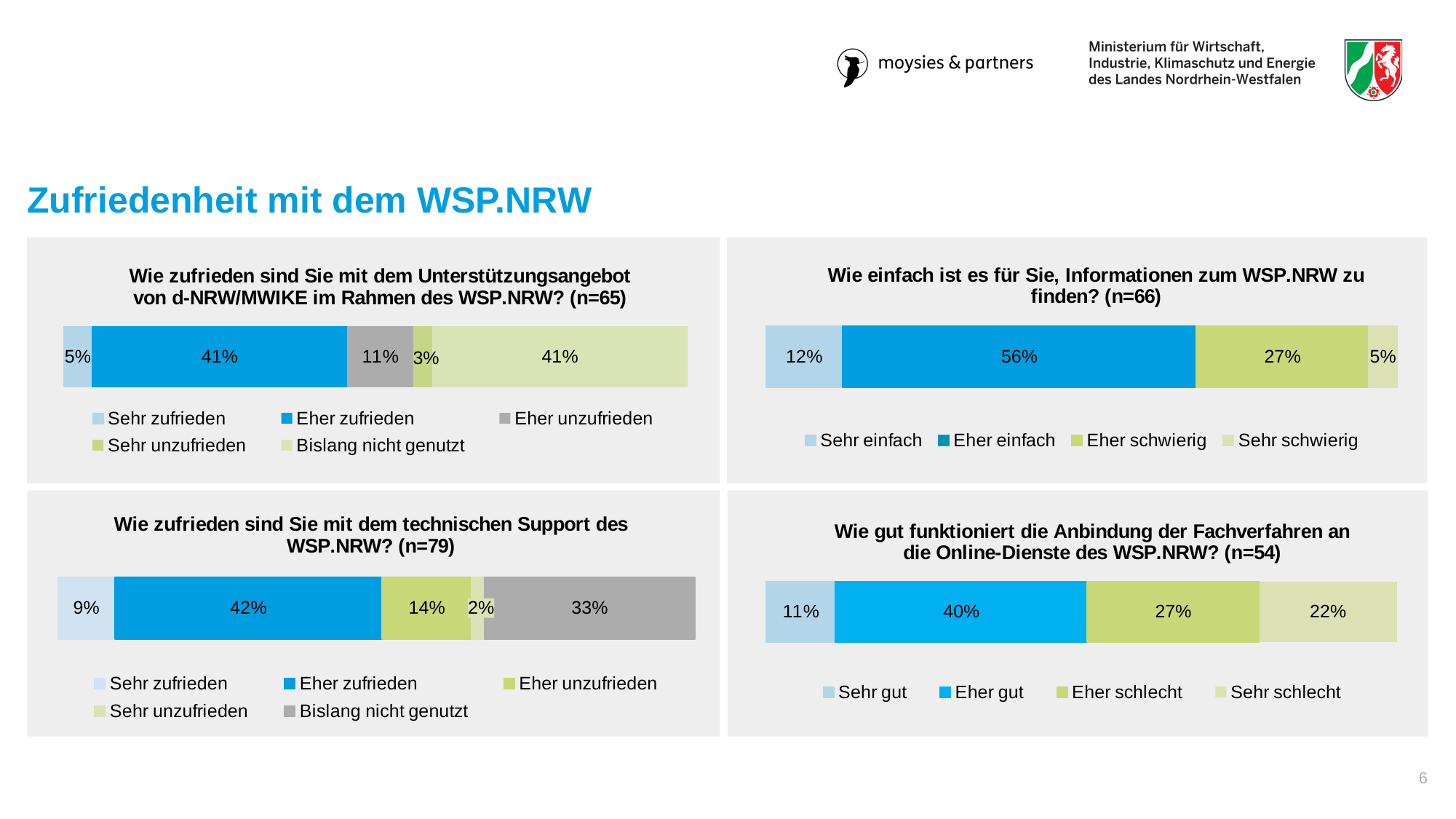
In the bottom-left chart (technischer Support), what share answered "Bislang nicht genutzt"? 33% In the top-right chart (Informationen zum WSP.NRW finden), what is the difference between the "Eher einfach" and "Eher schwierig" shares? 29 percentage points In the bottom-left chart (technischer Support), which answer category has the largest share? Eher zufrieden In the bottom-left chart (technischer Support), which is larger: the "Sehr zufrieden" share or the "Eher unzufrieden" share? Eher unzufrieden What type of chart is used in the top-left panel (Unterstützungsangebot von d-NRW/MWIKE)? Stacked bar chart In the bottom-right chart (Anbindung der Fachverfahren), what is the difference between the "Eher gut" and "Sehr gut" shares? 29 percentage points In the top-right chart (Informationen zum WSP.NRW finden), which answer category has the smallest share? Sehr schwierig In the top-left chart (Unterstützungsangebot von d-NRW/MWIKE), what share of respondents answered "Eher zufrieden"? 41% How many answer categories does the legend of the bottom-right chart (Anbindung der Fachverfahren) list? 4 In the top-left chart (Unterstützungsangebot von d-NRW/MWIKE), what share answered "Sehr unzufrieden"? 3% In the bottom-right chart (Anbindung der Fachverfahren), what share answered "Sehr schlecht"? 22% In the top-right chart (Informationen zum WSP.NRW finden), what share answered "Eher einfach"? 56%